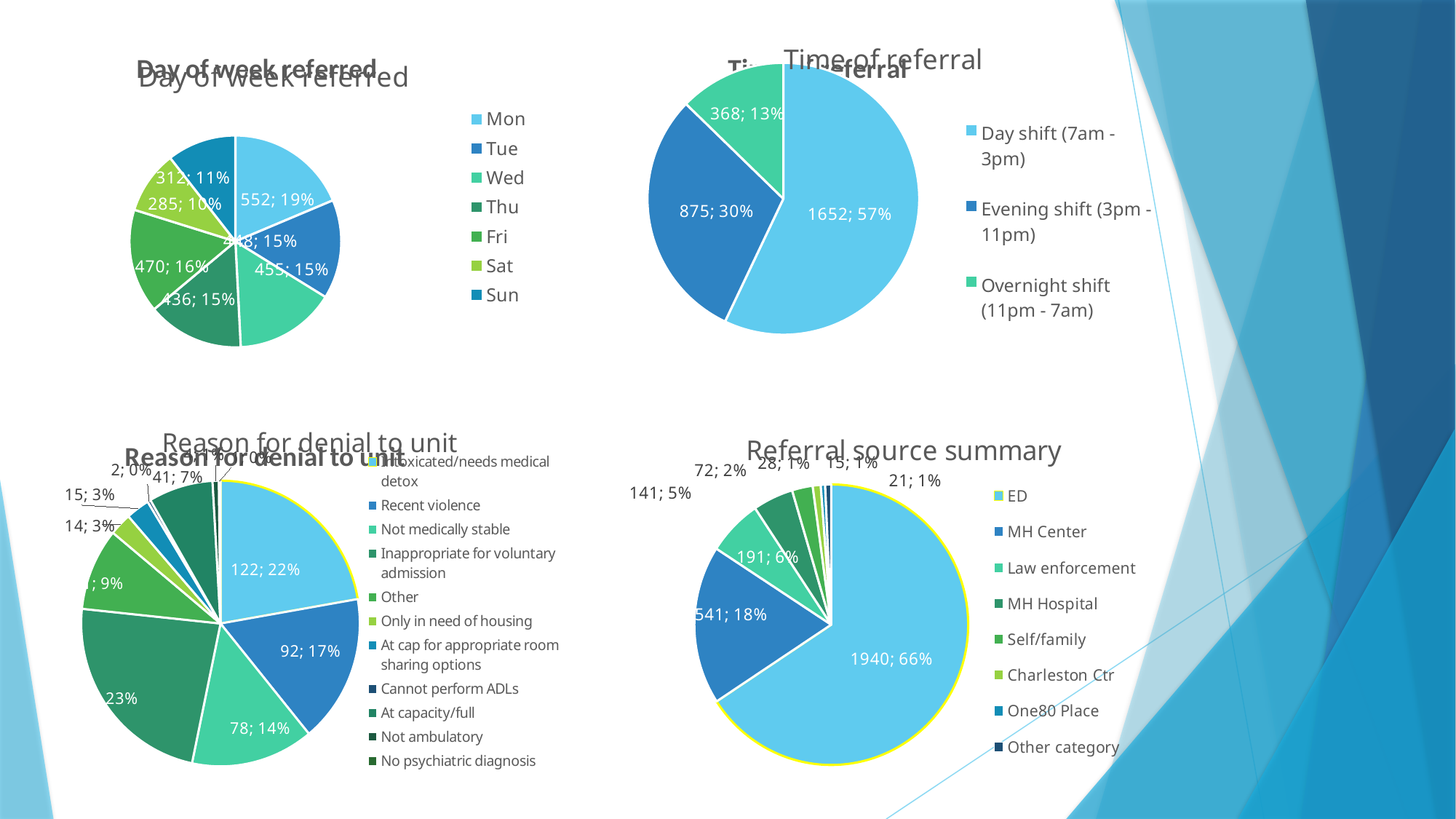
In the 'Day of week referred' chart, which day has the smallest share of referrals? Sat In the 'Time of referral' chart, which shift has the largest share of referrals? Day shift (7am - 3pm) In the 'Time of referral' chart, what is the value for the Overnight shift (11pm - 7am)? 368; 13% In the 'Referral source summary' chart, what is the value for ED? 1940; 66% In the 'Time of referral' chart, what is the difference in count between the Evening shift and the Overnight shift? 507 In the 'Time of referral' chart, what is the value for the Day shift (7am - 3pm)? 1652; 57% In the 'Day of week referred' chart, how many categories does the legend list? 7 In the 'Day of week referred' chart, what is the value for Mon? 552; 19% In the 'Referral source summary' chart, which is larger, Law enforcement or MH Hospital? Law enforcement In the 'Reason for denial to unit' chart, what is the value for Recent violence? 92; 17% What type of chart is used for 'Referral source summary'? Pie chart In the 'Referral source summary' chart, what is the value for MH Center? 541; 18%